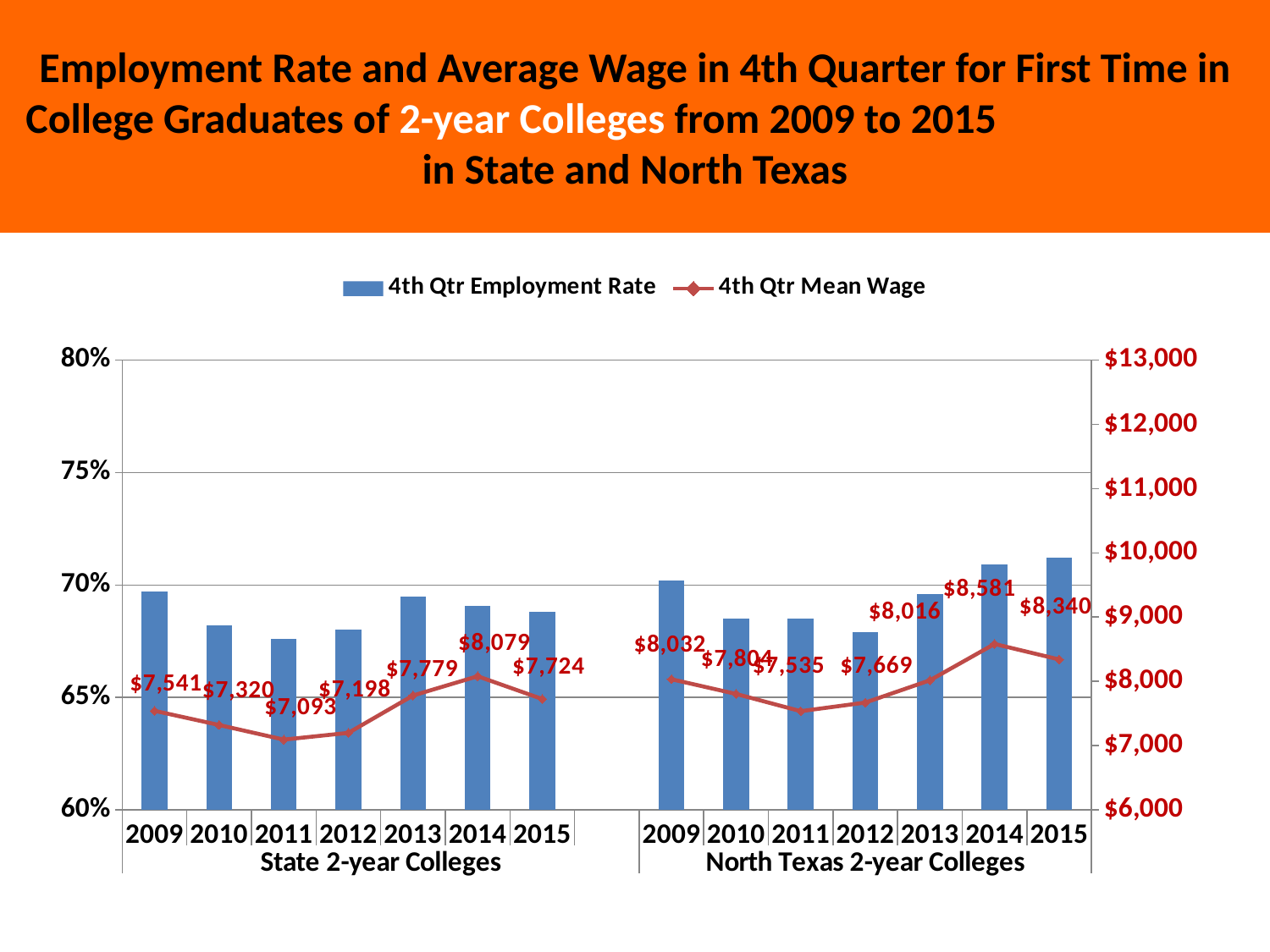
Does the 4th Qtr Mean Wage at North Texas 2-year Colleges rise or fall from 2009 to 2011? fall Which year and group has the highest 4th Qtr Mean Wage on the chart? 2014, North Texas 2-year Colleges Which has the higher 4th Qtr Mean Wage in 2013: State 2-year Colleges or North Texas 2-year Colleges? North Texas 2-year Colleges What is the difference between the 4th Qtr Mean Wage for 2014 and 2011 at State 2-year Colleges? $986 What is the 4th Qtr Mean Wage for 2015 at State 2-year Colleges? $7,724 Is the 4th Qtr Employment Rate for 2014 at North Texas 2-year Colleges greater or less than 70%? greater How many series does the legend list? 2 Is the 4th Qtr Employment Rate for 2011 at State 2-year Colleges greater or less than 70%? less Which year and group has the lowest 4th Qtr Mean Wage on the chart? 2011, State 2-year Colleges What is the 4th Qtr Mean Wage for 2011 at State 2-year Colleges? $7,093 What is the 4th Qtr Mean Wage for 2014 at North Texas 2-year Colleges? $8,581 How many years are shown for each college group on the x axis? 7